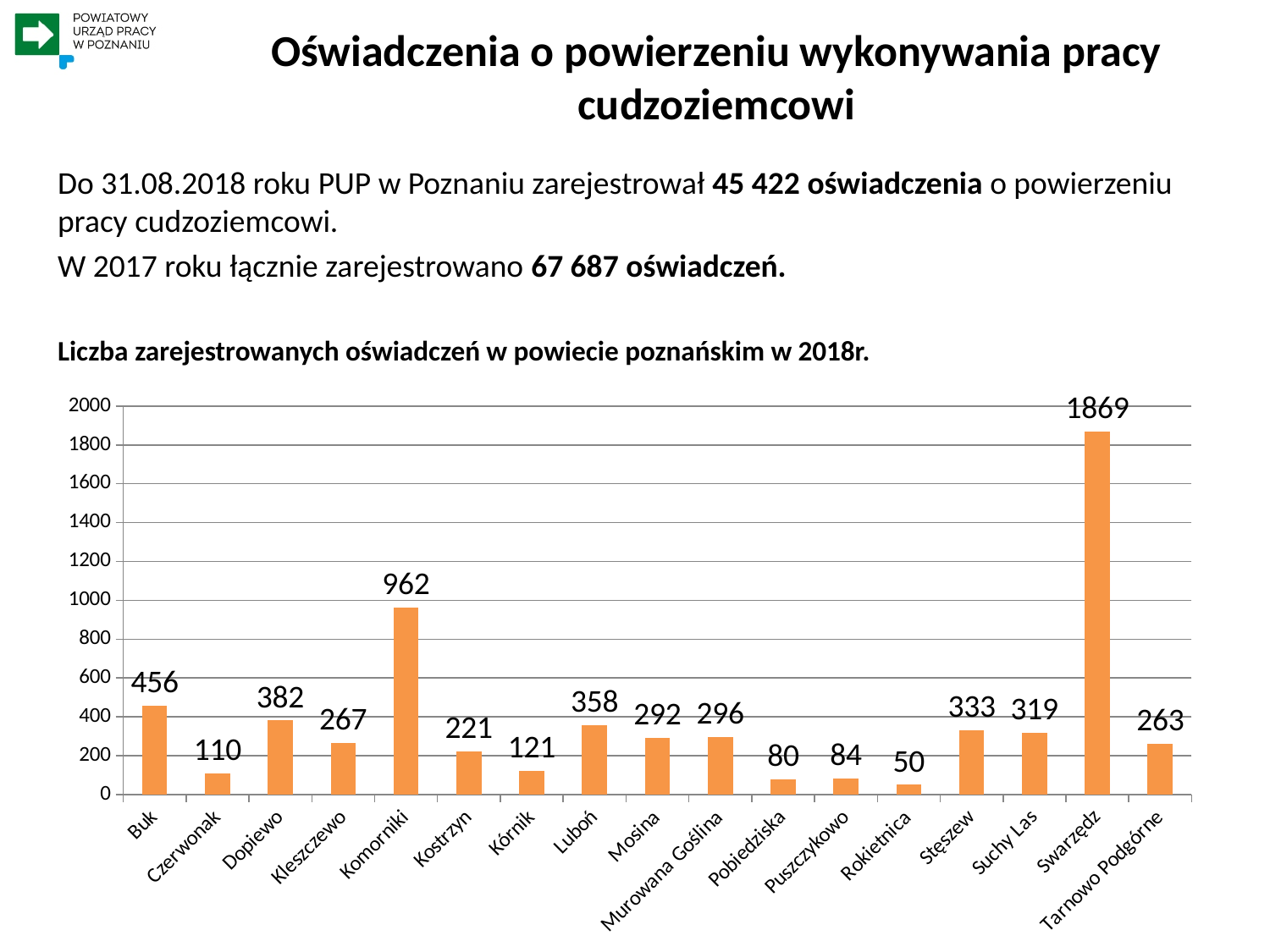
Is the value for Luboń greater or less than 400? less Which is larger, the value for Buk or the value for Dopiewo? Buk What is the value for Czerwonak? 110 Which category has the lowest value? Rokietnica What is the difference between the values for Swarzędz and Komorniki? 907 Which category has the highest value? Swarzędz What kind of chart is shown on the slide? bar chart What is the title of the chart? Liczba zarejestrowanych oświadczeń w powiecie poznańskim w 2018r. What is the difference between the values for Stęszew and Suchy Las? 14 What is the value for Tarnowo Podgórne? 263 What is the value for Komorniki? 962 How many categories are shown on the x axis? 17